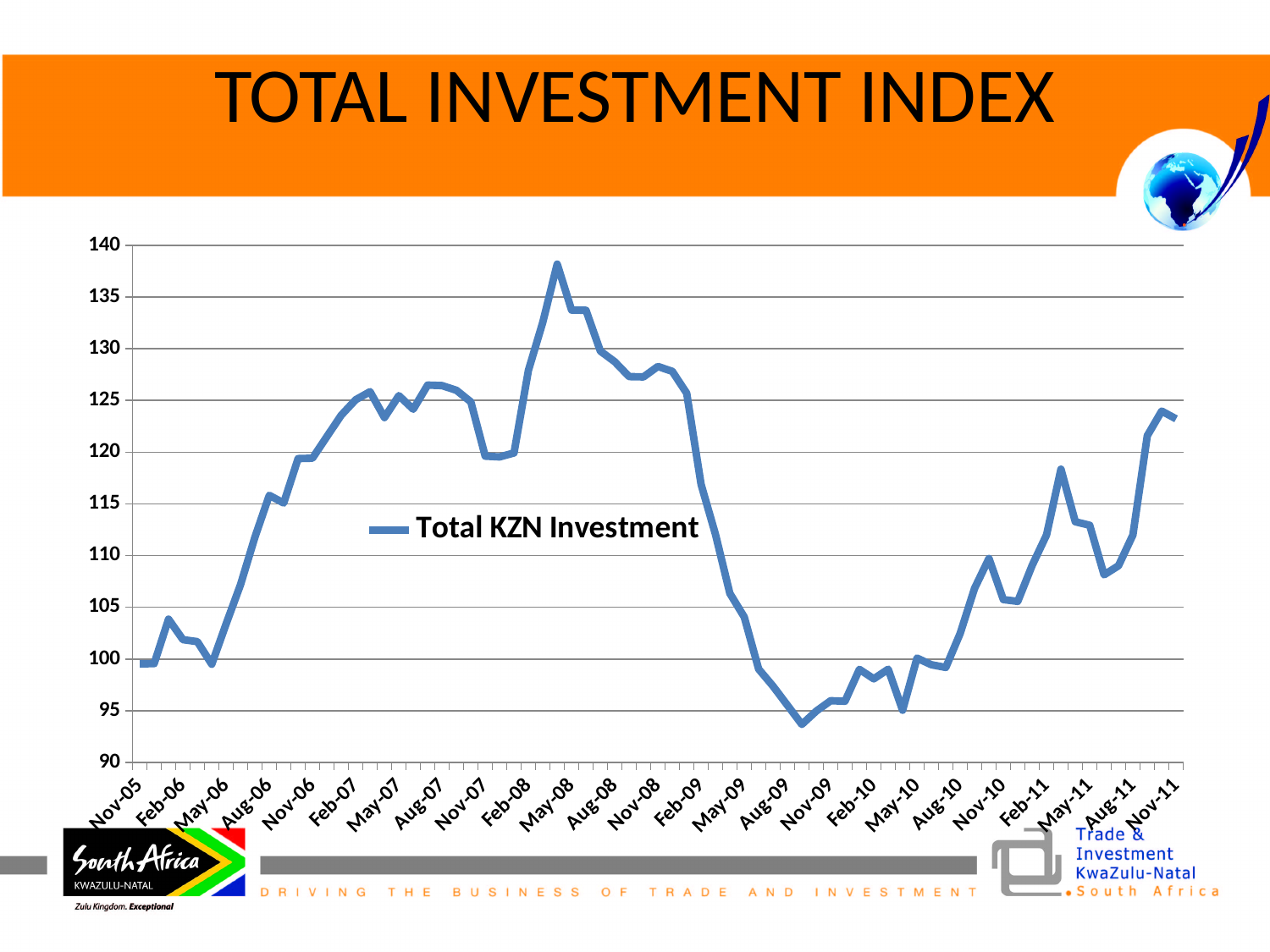
Is the value for May-08 greater or less than 135? less Does the Total KZN Investment line rise or fall between May-08 and Nov-09? fall What is the name of the series shown in the legend? Total KZN Investment How many series does the legend list? 1 Is the value for Nov-09 greater or less than 100? less What is the title of the chart? TOTAL INVESTMENT INDEX What kind of chart is shown on the slide? Line chart Which is larger, the value for May-08 or the value for Nov-09? May-08 How many month labels are shown on the x axis? 25 Is the value for Nov-11 greater or less than 120? greater At which labeled month does the Total KZN Investment line reach its highest value? May-08